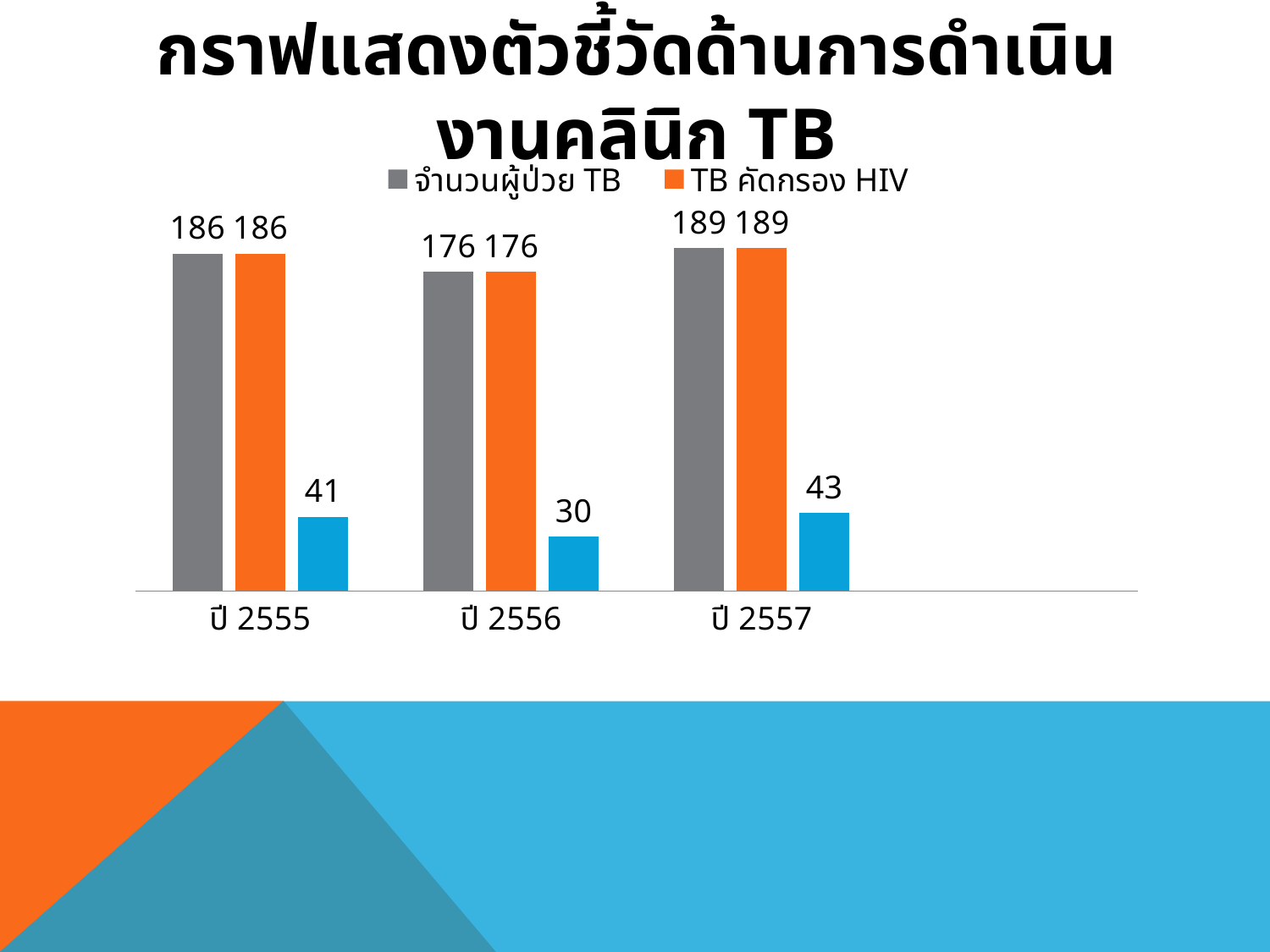
What is the value of จำนวนผู้ป่วย TB for ปี 2557? 189 Does the value of จำนวนผู้ป่วย TB rise or fall from ปี 2556 to ปี 2557? rise Which year has the lowest value for TB คัดกรอง HIV? ปี 2556 What is the difference between จำนวนผู้ป่วย TB in ปี 2557 and ปี 2556? 13 What is the value of จำนวนผู้ป่วย TB for ปี 2555? 186 Which year has the highest value for จำนวนผู้ป่วย TB? ปี 2557 What is the value of TB คัดกรอง HIV for ปี 2556? 176 What is the difference between TB คัดกรอง HIV in ปี 2555 and ปี 2556? 10 Which year has the larger value for จำนวนผู้ป่วย TB, ปี 2555 or ปี 2556? ปี 2555 What kind of chart is shown on the slide? bar chart How many years are shown on the x axis? 3 How many series does the legend list? 2